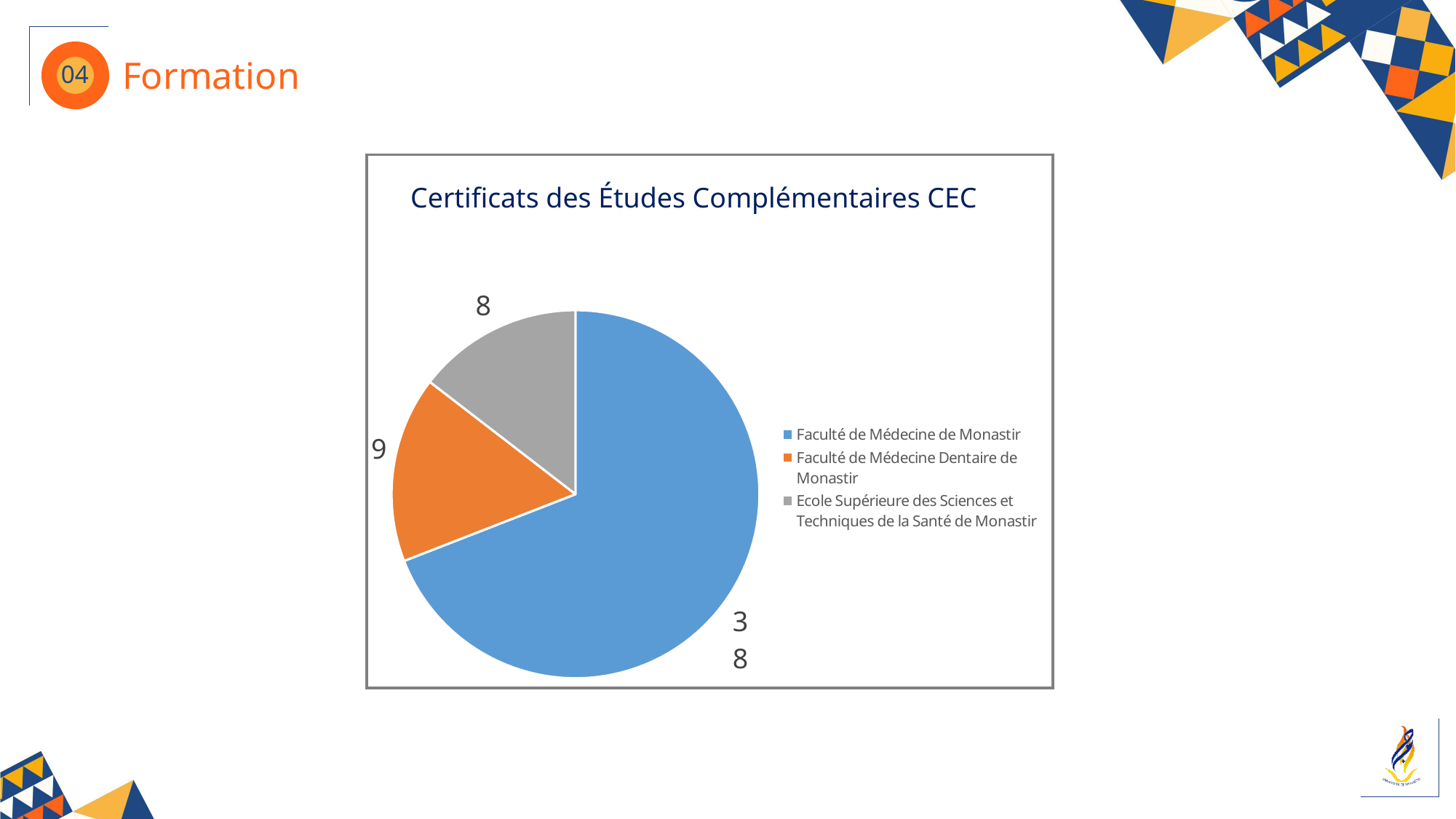
What colour is the slice for Faculté de Médecine Dentaire de Monastir? Orange Which category has the smallest slice of the pie? Ecole Supérieure des Sciences et Techniques de la Santé de Monastir What is the difference between the values for Faculté de Médecine Dentaire de Monastir and Ecole Supérieure des Sciences et Techniques de la Santé de Monastir? 1 What type of chart is shown on the slide? Pie chart What is the difference between the values for Faculté de Médecine de Monastir and Faculté de Médecine Dentaire de Monastir? 29 Which category has the largest slice of the pie? Faculté de Médecine de Monastir What is the value for Ecole Supérieure des Sciences et Techniques de la Santé de Monastir? 8 Which is larger: the value for Faculté de Médecine Dentaire de Monastir or the value for Ecole Supérieure des Sciences et Techniques de la Santé de Monastir? Faculté de Médecine Dentaire de Monastir What is the value for Faculté de Médecine Dentaire de Monastir? 9 What is the value for Faculté de Médecine de Monastir? 38 How many categories does the pie chart show? 3 What is the title of the chart? Certificats des Études Complémentaires CEC